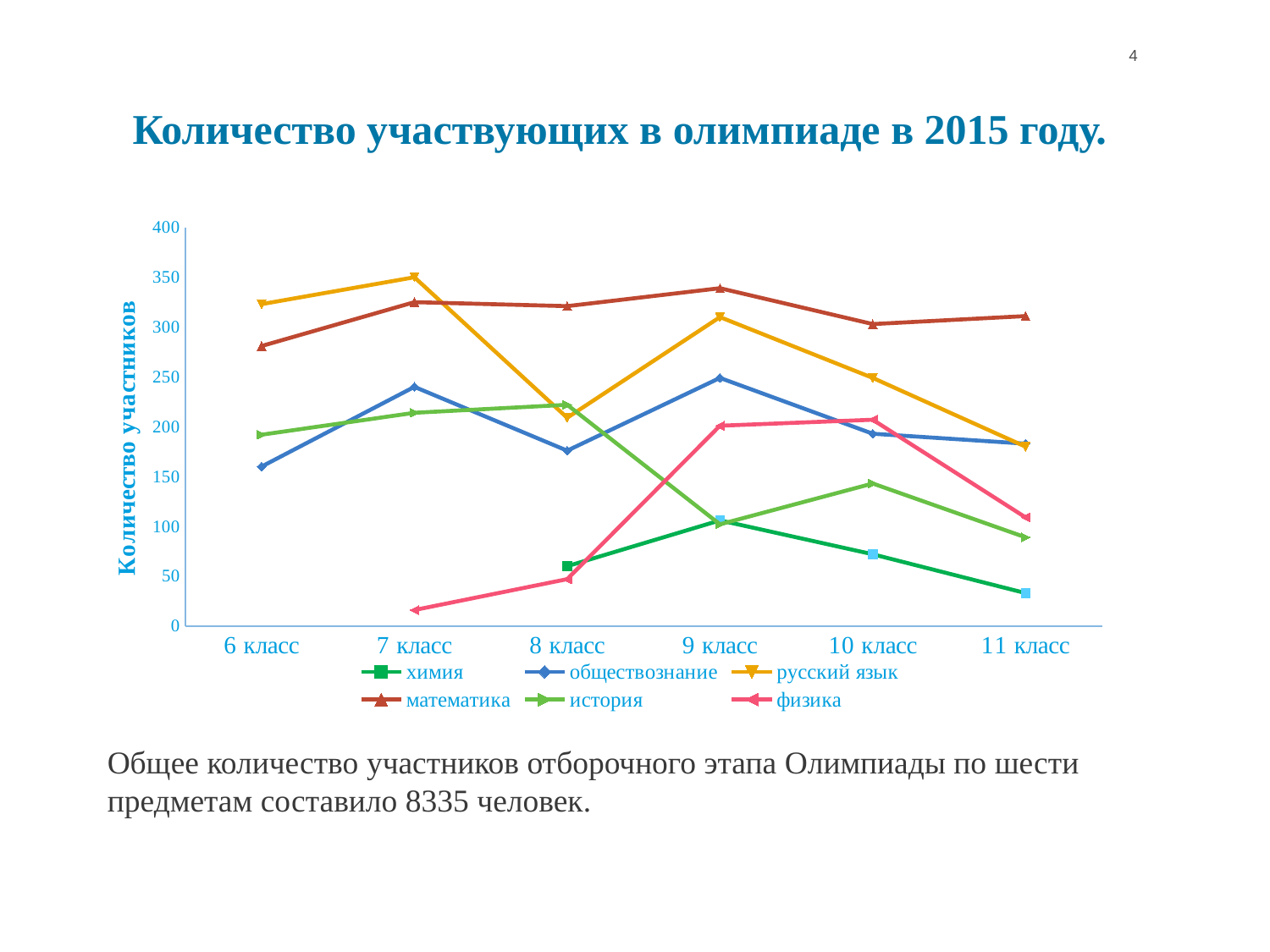
Is the value for математика in 6 класс greater or less than 300? less How many series does the legend list? 6 What is the title of the vertical axis? Количество участников How many class categories are shown on the x axis? 6 Is the value for физика in 7 класс greater or less than 50? less Is the value for русский язык in 7 класс greater or less than 300? greater Does the number of participants in химия rise or fall from 9 класс to 11 класс? fall In 6 класс, which has more participants: история or обществознание? история Which subject has the highest number of participants in 7 класс? русский язык Which subject has the highest number of participants in 9 класс? математика Which subject has the lowest number of participants in 11 класс? химия What kind of chart is shown on the slide? line chart